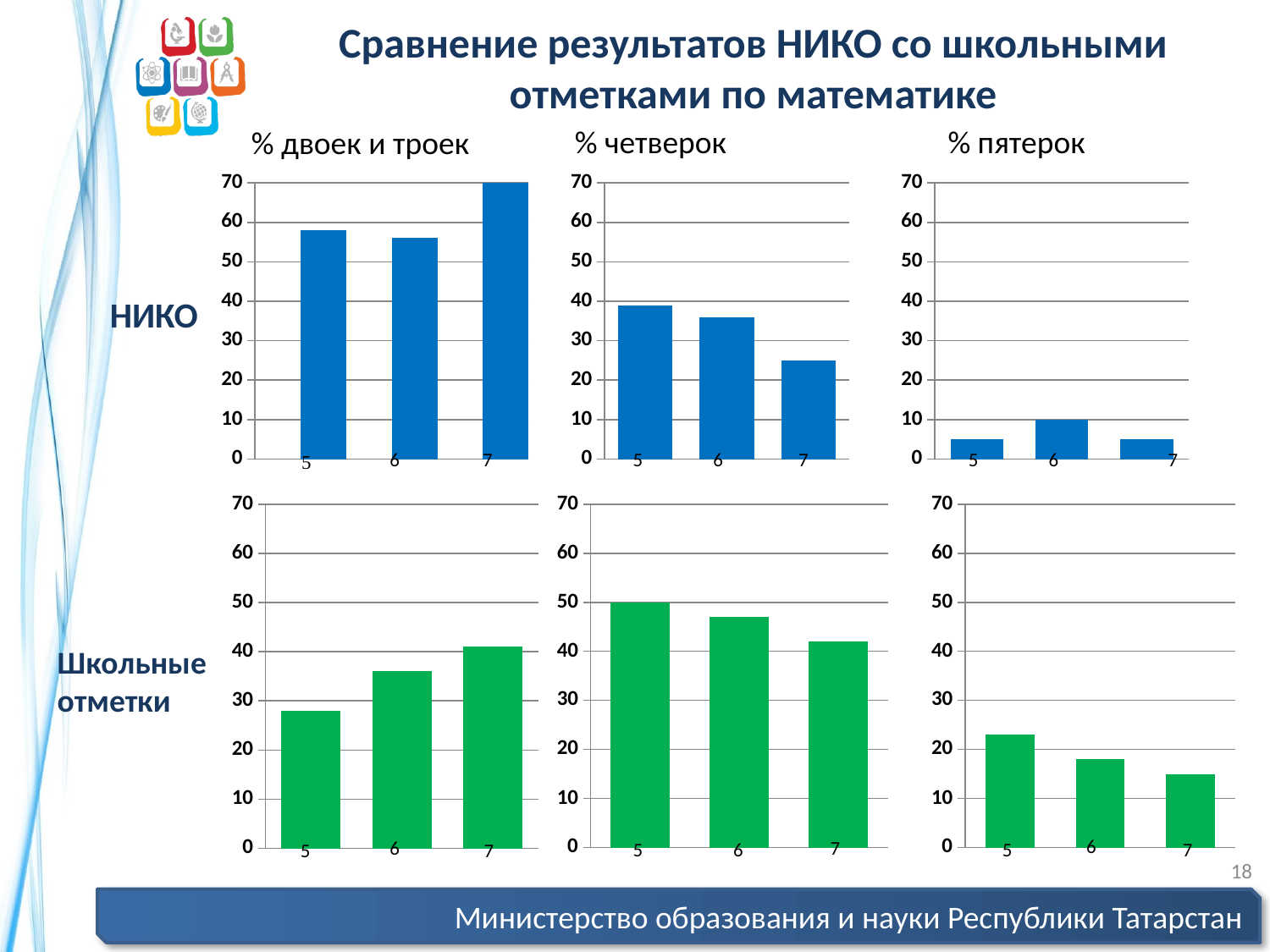
In the НИКО chart for % двоек и троек, which grade has the highest value? 7 In the НИКО chart for % четверок, is the value for grade 7 greater or less than 30? less In the НИКО chart for % четверок, do the values rise or fall from grade 5 to grade 7? fall In the Школьные отметки chart for % четверок, what is the value for grade 5? 50 In the Школьные отметки chart for % двоек и троек, do the values rise or fall from grade 5 to grade 7? rise How many grade categories are shown in the Школьные отметки chart for % четверок? 3 In the Школьные отметки chart for % пятерок, is the value for grade 7 greater or less than 20? less In the НИКО chart for % пятерок, which grade has the highest value? 6 In the Школьные отметки chart for % пятерок, which grade has the lowest value? 7 In the НИКО chart for % пятерок, what is the value for grade 6? 10 In the НИКО chart for % двоек и троек, is the value for grade 5 greater or less than 50? greater